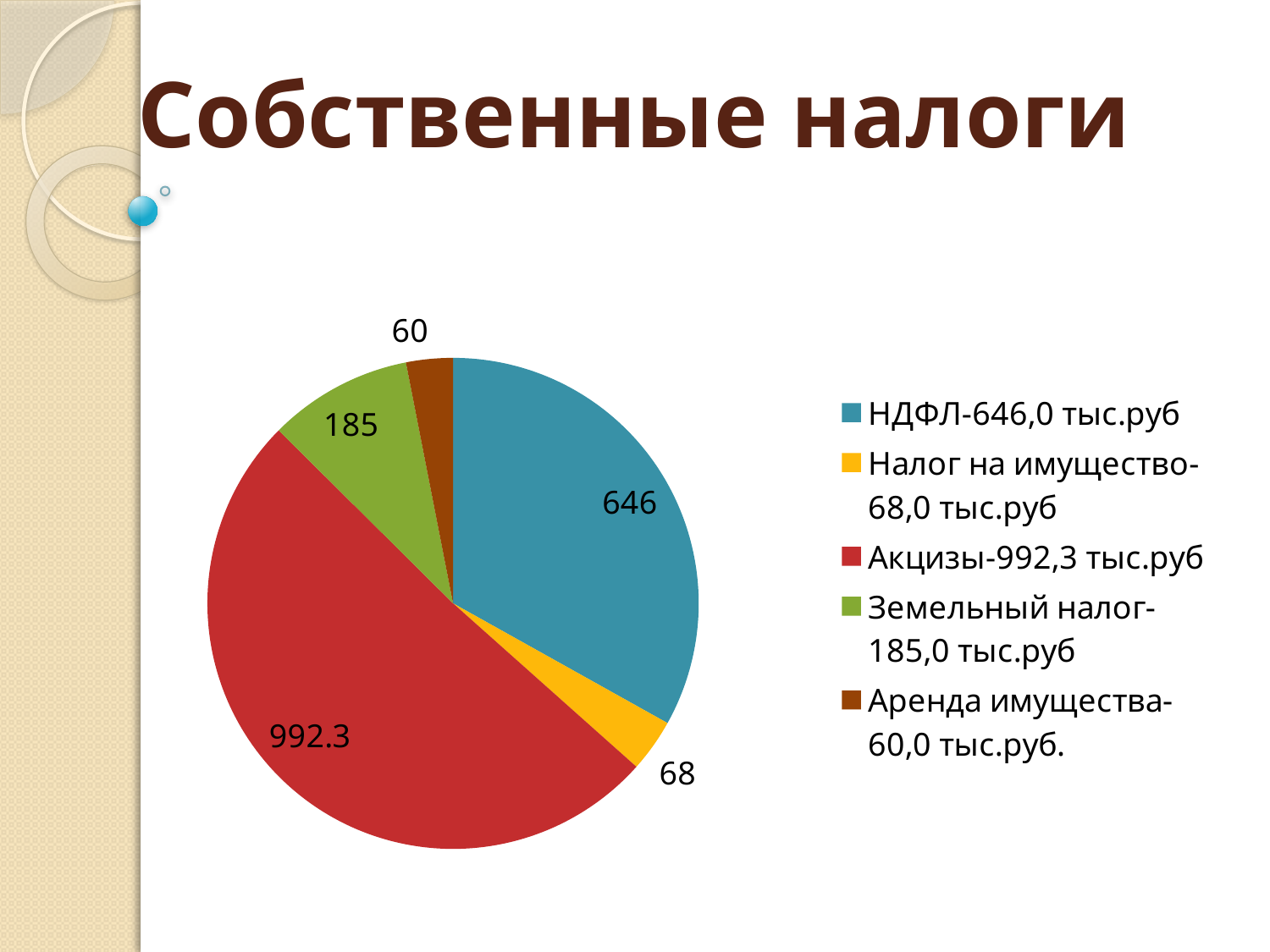
What type of chart is shown on the slide? pie chart What is the value of the Аренда имущества slice? 60 Which category has the largest slice of the pie? Акцизы What is the value of the НДФЛ slice? 646 What is the title of the slide containing the chart? Собственные налоги What is the value of the Акцизы slice? 992.3 Which is larger, the Земельный налог slice or the Налог на имущество slice? Земельный налог Which category has the smallest slice of the pie? Аренда имущества How many slices does the pie chart have? 5 What is the difference between the Акцизы value and the НДФЛ value? 346.3 What is the value of the Земельный налог slice? 185